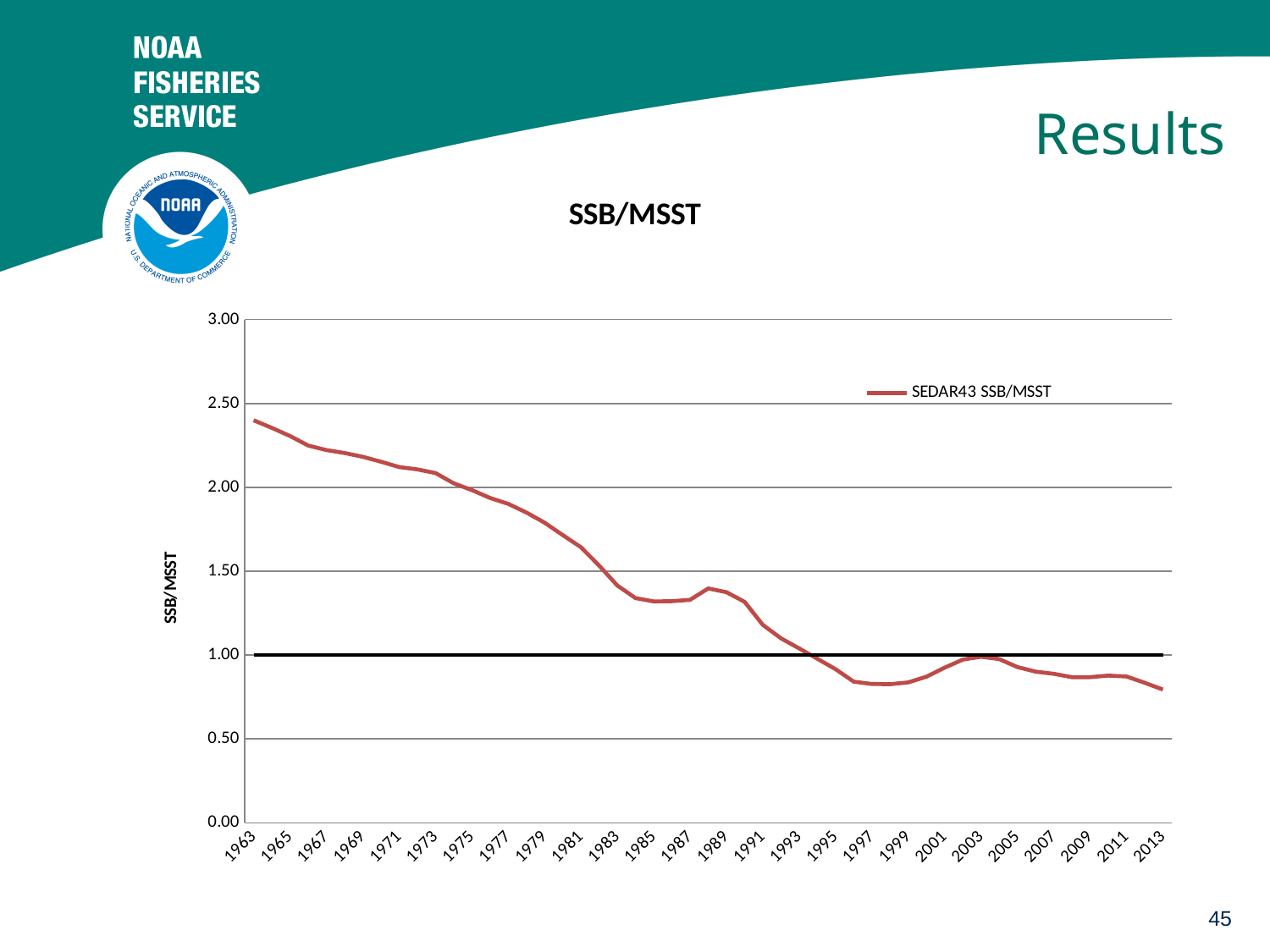
Does the SEDAR43 SSB/MSST value generally rise or fall from 1963 to 2013? fall What is the name of the series shown in the legend? SEDAR43 SSB/MSST Is the SEDAR43 SSB/MSST value for 2013 greater or less than 1.00? less In which year is the SEDAR43 SSB/MSST value highest? 1963 Is the SEDAR43 SSB/MSST value for 1963 greater or less than 2.00? greater What is the title of the chart? SSB/MSST Is the SEDAR43 SSB/MSST value for 1997 greater or less than 1.00? less Which year has the larger SEDAR43 SSB/MSST value, 1981 or 1991? 1981 Which year has the larger SEDAR43 SSB/MSST value, 1963 or 2013? 1963 What kind of chart is shown on the slide? line chart How many series does the chart legend list? 1